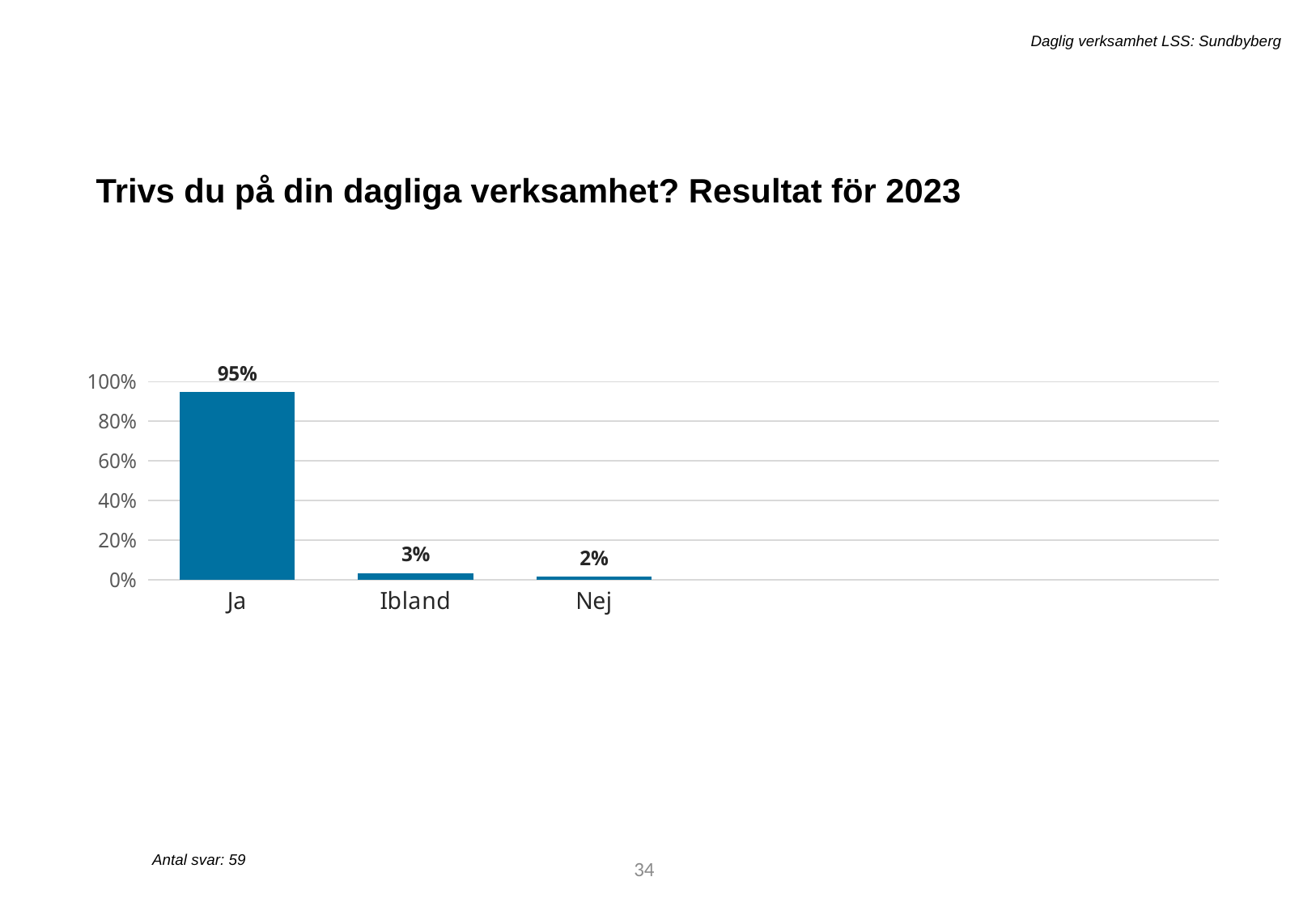
What is the value for Nej? 2% Is the value for Ja greater or less than 80%? greater Which is larger, the value for Ja or the value for Nej? Ja Which category has the lowest value? Nej How many categories are shown on the x axis? 3 Which category has the highest value? Ja What is the value for Ibland? 3% What kind of chart is shown on the slide? bar chart What is the title of the slide above the chart? Trivs du på din dagliga verksamhet? Resultat för 2023 What is the difference between the values for Ja and Ibland? 92% What is the value for Ja? 95% What is the difference between the values for Ibland and Nej? 1%